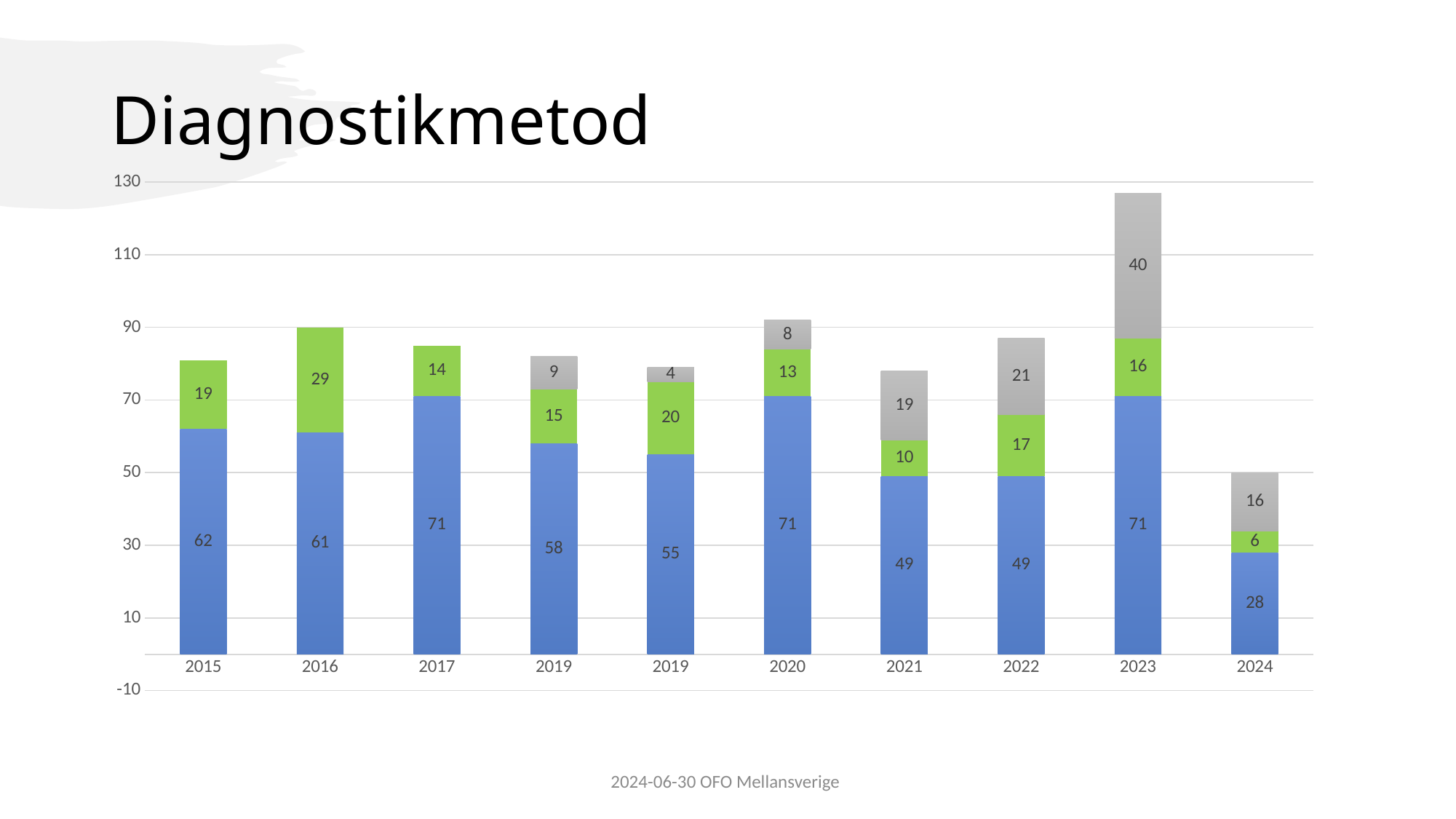
What is the total of the stacked bar for 2023? 127 Which is larger, the green segment for 2016 or the green segment for 2022? 2016 What is the value of the green segment for 2016? 29 What is the difference between the blue segment for 2017 and the blue segment for 2024? 43 How many bars are plotted in the chart? 10 What is the value of the grey segment for 2023? 40 What is the value of the grey segment for 2021? 19 Which year has the tallest stacked bar? 2023 What is the value of the blue segment for 2015? 62 What kind of chart is shown on the slide? Stacked bar chart Which year has the shortest stacked bar? 2024 What is the total of the stacked bar for 2024? 50